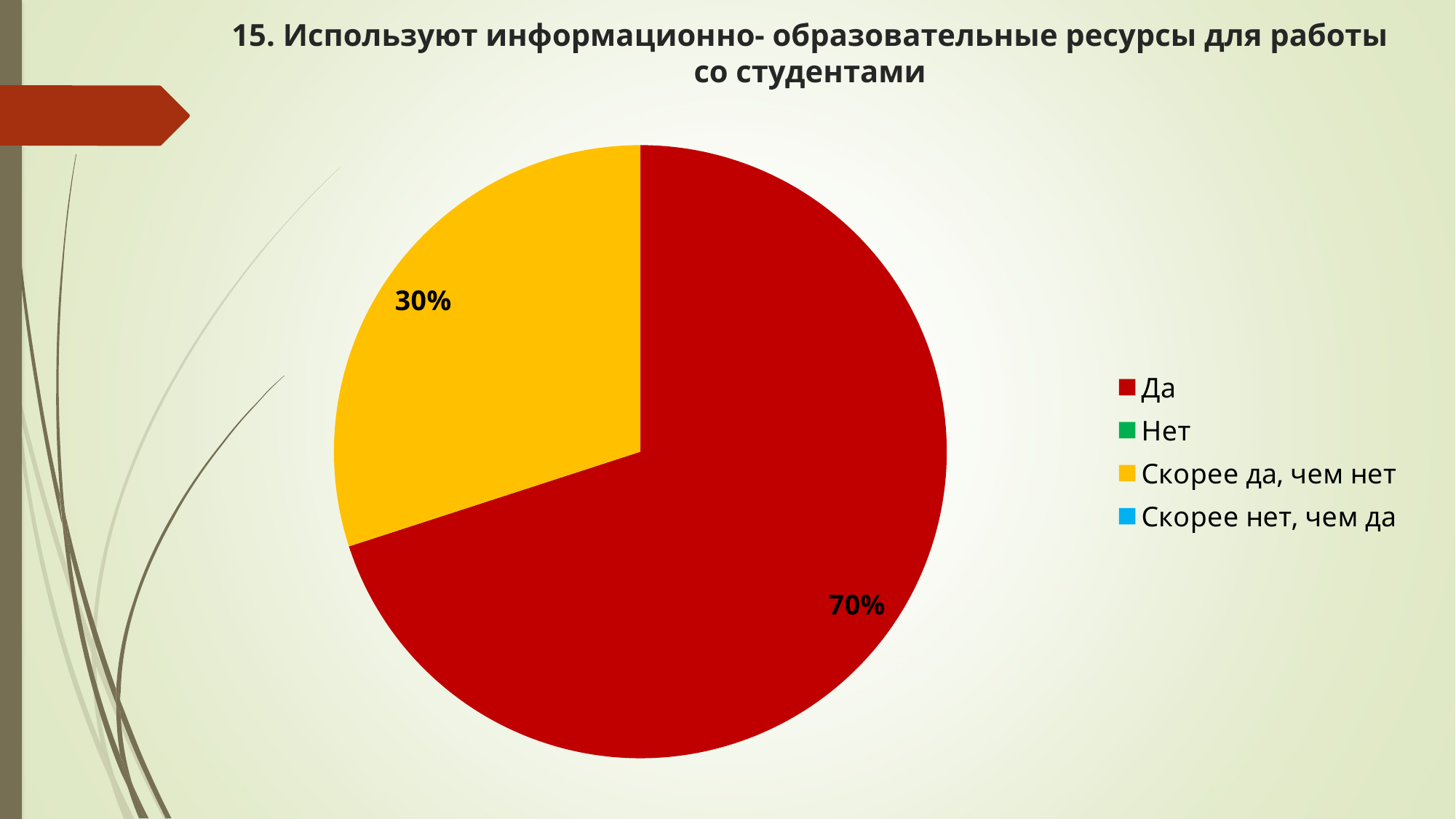
What share of the pie does the "Скорее да, чем нет" slice represent? 30% Which legend entry is shown in red? Да What is the difference in percentage points between the "Да" slice and the "Скорее да, чем нет" slice? 40% Which category has the largest slice of the pie? Да What colour is the "Скорее да, чем нет" slice? Yellow How many entries does the legend list? 4 Which of the two visible slices is larger, "Да" or "Скорее да, чем нет"? Да Is the share for "Да" greater or less than 50%? greater What share of the pie does the "Да" slice represent? 70% How many slices are visible in the pie? 2 What kind of chart is shown on the slide? Pie chart